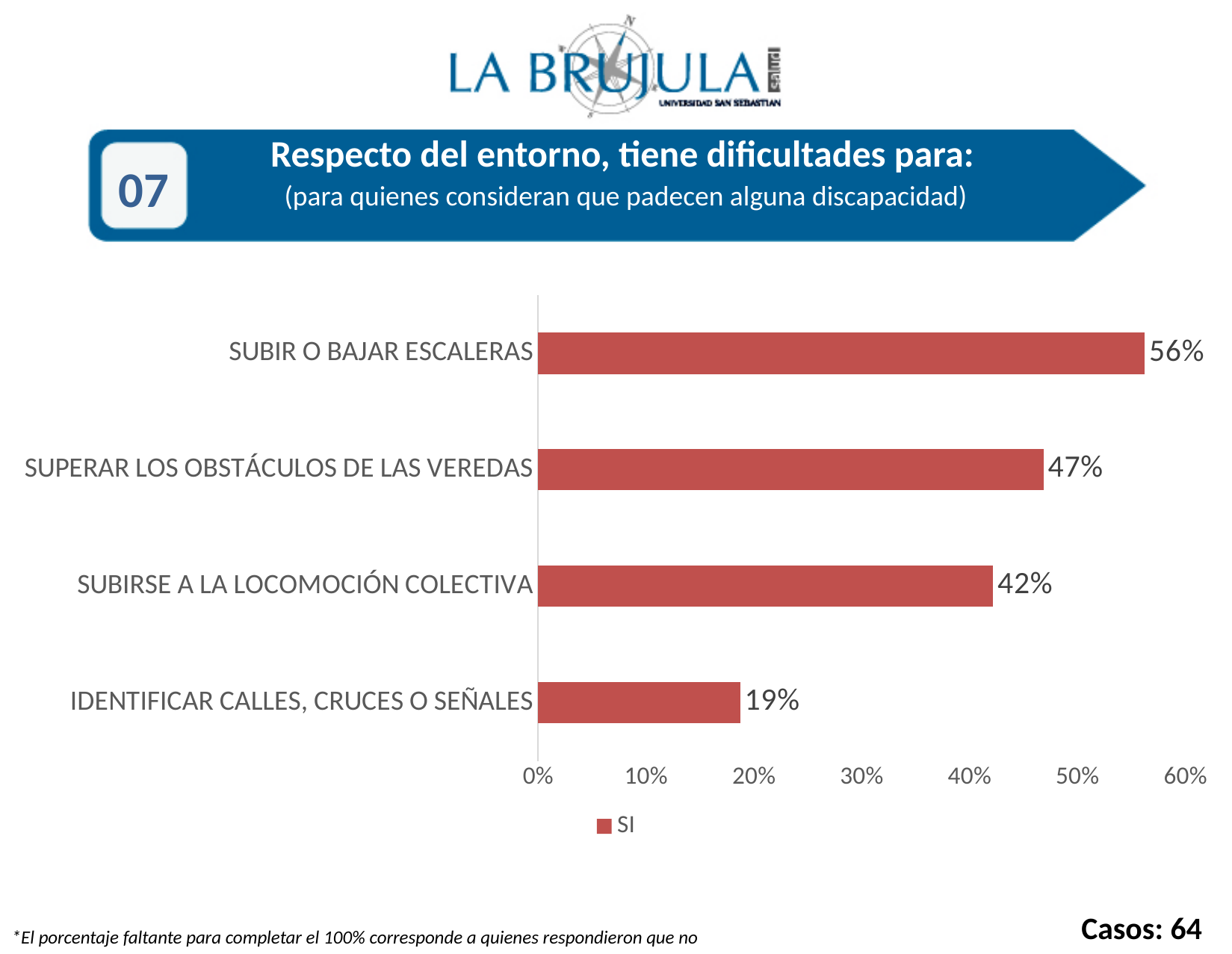
What is the value for SUPERAR LOS OBSTÁCULOS DE LAS VEREDAS? 47% Is the value for SUBIRSE A LA LOCOMOCIÓN COLECTIVA greater or less than 40%? greater Which category has the highest value? SUBIR O BAJAR ESCALERAS What kind of chart is shown on the slide? bar chart What series does the legend list? SI What is the value for SUBIRSE A LA LOCOMOCIÓN COLECTIVA? 42% How many categories are shown in the chart? 4 What is the value for IDENTIFICAR CALLES, CRUCES O SEÑALES? 19% Which category has the lowest value? IDENTIFICAR CALLES, CRUCES O SEÑALES What is the value for SUBIR O BAJAR ESCALERAS? 56% Which is larger, the value for SUPERAR LOS OBSTÁCULOS DE LAS VEREDAS or the value for SUBIRSE A LA LOCOMOCIÓN COLECTIVA? SUPERAR LOS OBSTÁCULOS DE LAS VEREDAS What is the difference between the values for SUBIR O BAJAR ESCALERAS and IDENTIFICAR CALLES, CRUCES O SEÑALES? 37%